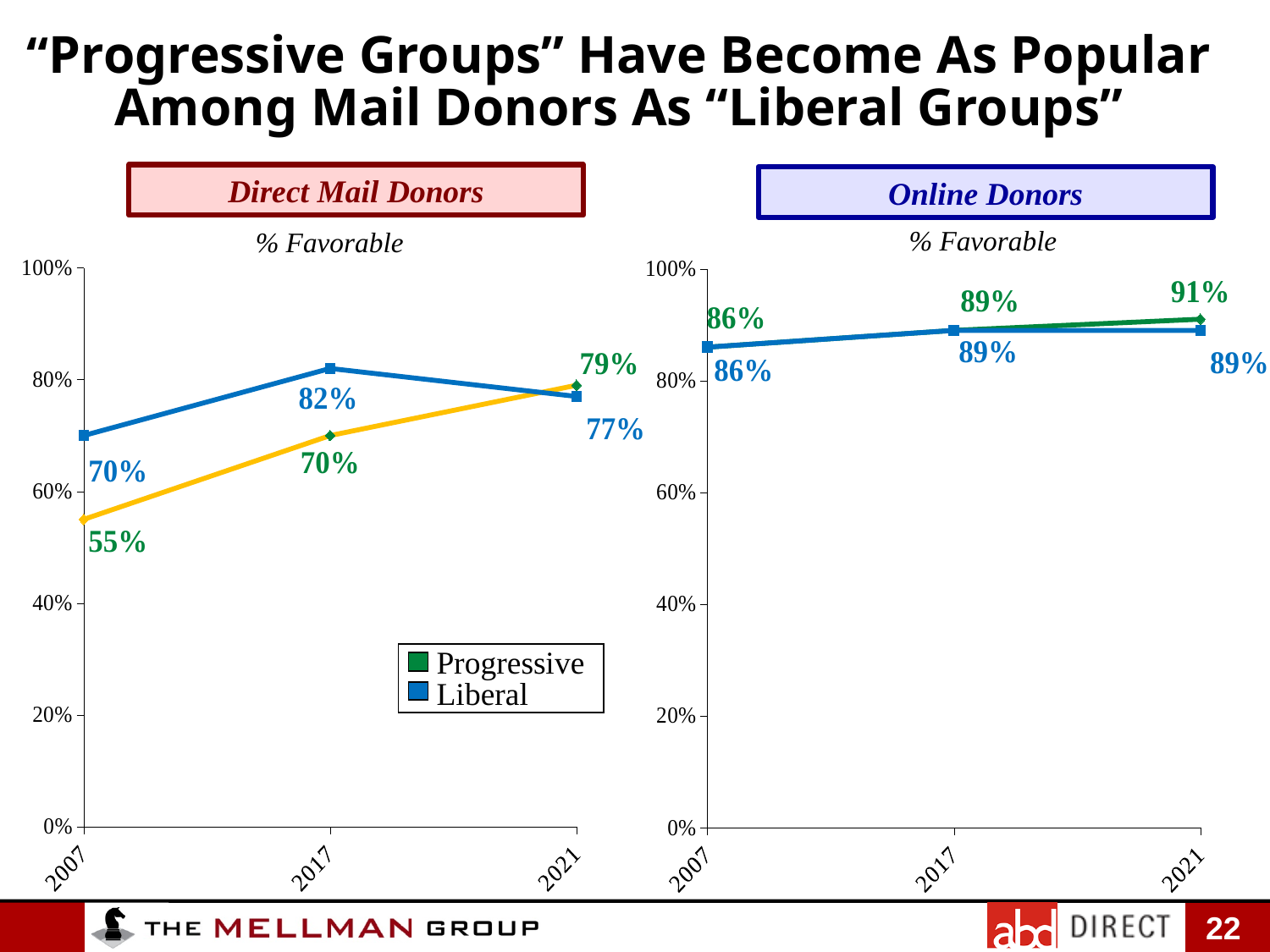
How many years are shown on the x axis of the Online Donors chart? 3 How many series does the legend list? 2 What kind of chart is the Direct Mail Donors chart? Line chart In the Online Donors chart, does the Progressive line rise or fall from 2007 to 2021? Rise In the Direct Mail Donors chart, what is the % favorable for Liberal in 2017? 82% In the Online Donors chart, what is the % favorable for Progressive in 2021? 91% In the Direct Mail Donors chart, which series has the higher value in 2021, Progressive or Liberal? Progressive In the Direct Mail Donors chart, what is the % favorable for Progressive in 2007? 55% In the Online Donors chart, what is the % favorable for Liberal in 2007? 86% In the Direct Mail Donors chart, in which year is the Progressive value lowest? 2007 In the Direct Mail Donors chart, what is the % favorable for Progressive in 2021? 79% In the Direct Mail Donors chart, what is the difference between the Liberal and Progressive values in 2007? 15 percentage points